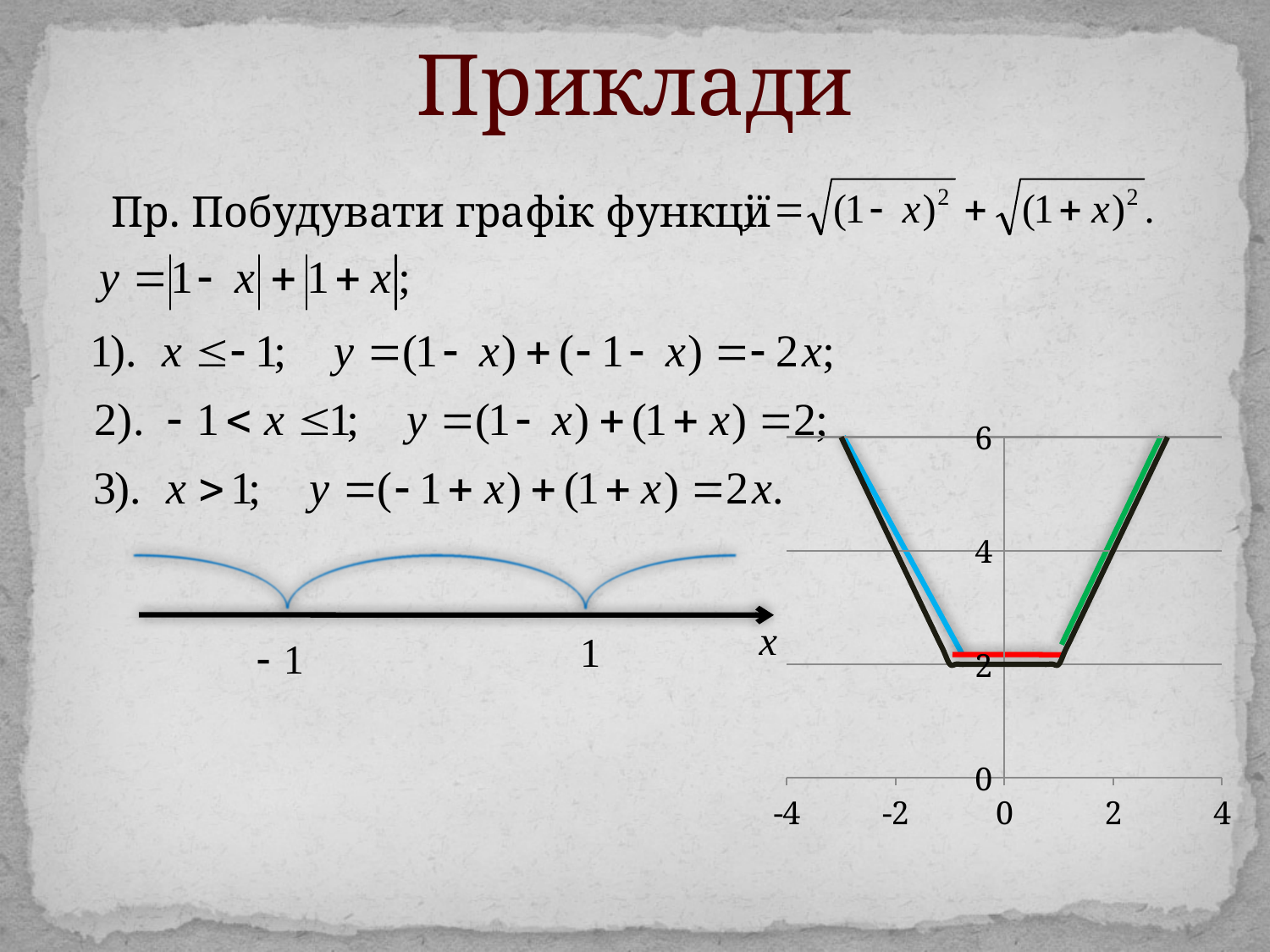
On the chart, is the value of y at x = -2 greater or less than 6? less On the chart, which is larger: the value of y at x = 2 or the value of y at x = 0? the value at x = 2 On the chart, what is the value of y at x = -2? 4 What kind of chart is shown on the right side of the slide? line chart On the chart, what is the value of y at x = 0? 2 On the chart, what is the value of y at x = 2? 4 What is the highest value labelled on the vertical axis of the chart? 6 What is the lowest value of y reached by the graph on the chart? 2 On the chart, is the value of y at x = 2 greater or less than 2? greater On the chart, does the graph rise or fall as x increases from -4 to 0? falls What colour is the flat middle segment of the graph on the chart? red On the chart, does the graph rise or fall as x increases from 0 to 4? rises